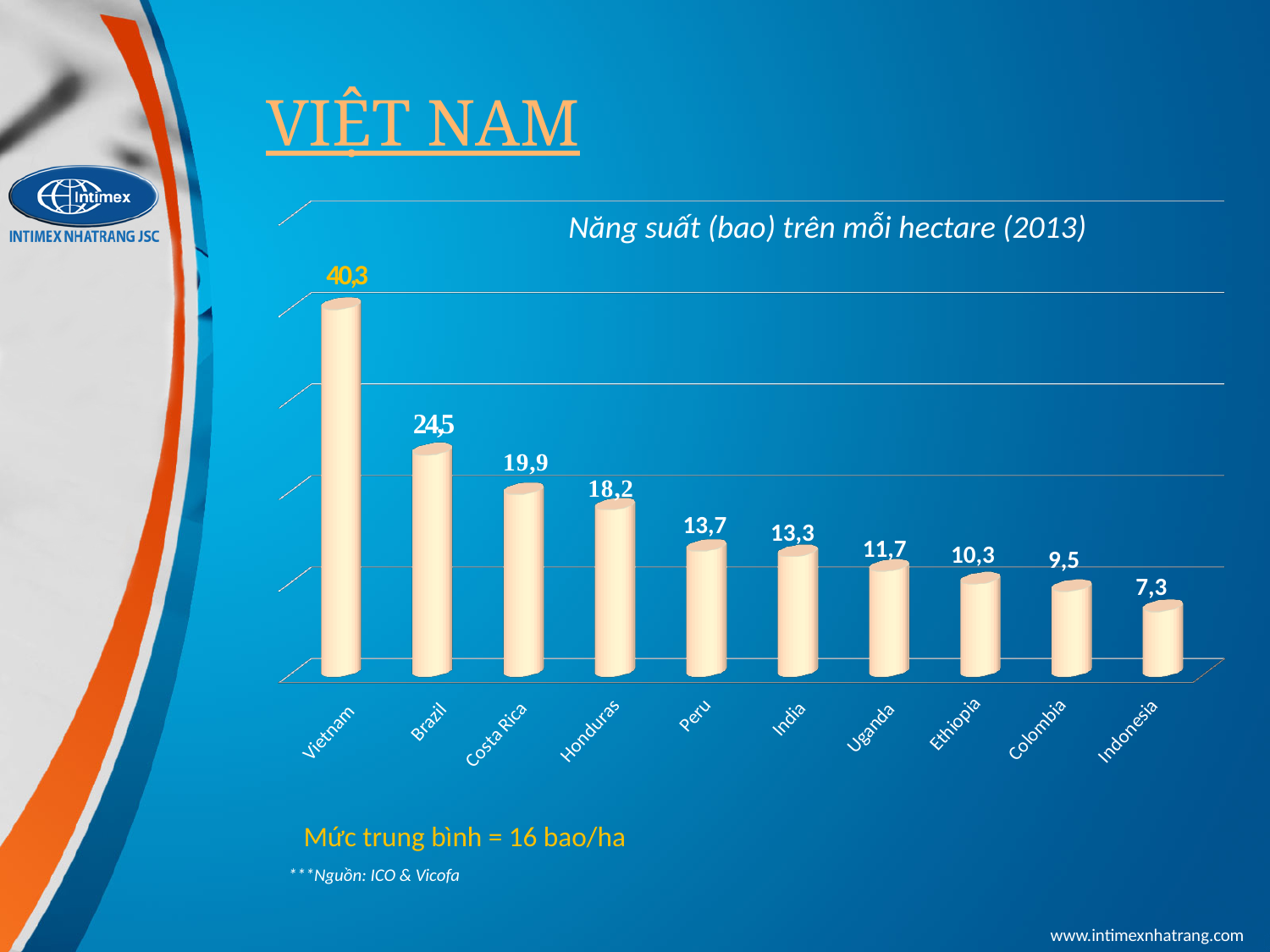
Which country has the highest value in the chart? Vietnam Which country has the lowest value in the chart? Indonesia What is the value for Brazil in the chart? 24,5 How many countries are shown in the chart? 10 What is the difference between the values for Costa Rica and Honduras? 1,7 Which has a larger value, Uganda or Colombia? Uganda What kind of chart is shown on the slide? Bar chart What is the title of the chart? Năng suất (bao) trên mỗi hectare (2013) What is the value for Indonesia in the chart? 7,3 What is the value for Vietnam in the chart? 40,3 What is the difference between the values for Vietnam and Brazil? 15,8 What is the value for Ethiopia in the chart? 10,3